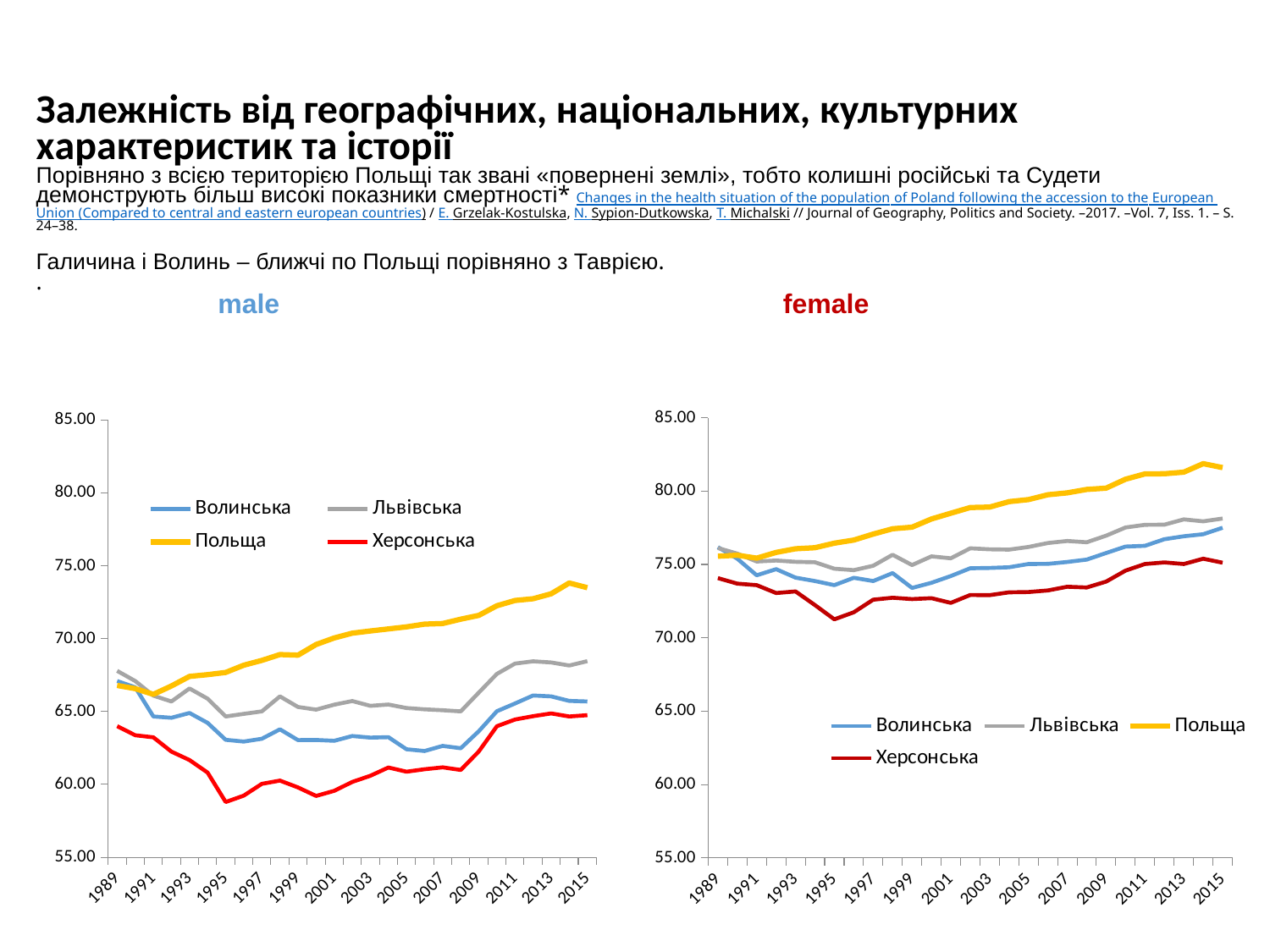
In the 'female' chart, is the value for Польща in 2015 greater or less than 80.00? greater In the 'male' chart, is the value for Польща in 2015 greater or less than 70.00? greater In the 'female' chart, which series has the highest value in 2015? Польща In the 'female' chart, which series has the lowest value in 2015? Херсонська In the 'male' chart, which series has the highest value in 2015? Польща In the 'male' chart, does the Польща series rise or fall from 1989 to 2015? rise In the 'female' chart, is the value for Херсонська in 1995 greater or less than 70.00? greater In the 'male' chart, which colour is used for the Польща series? yellow How many series does the legend of the 'female' chart list? 4 What type of chart is the 'male' chart on the left? line chart In the 'male' chart, which series has the lowest value in 2015? Херсонська